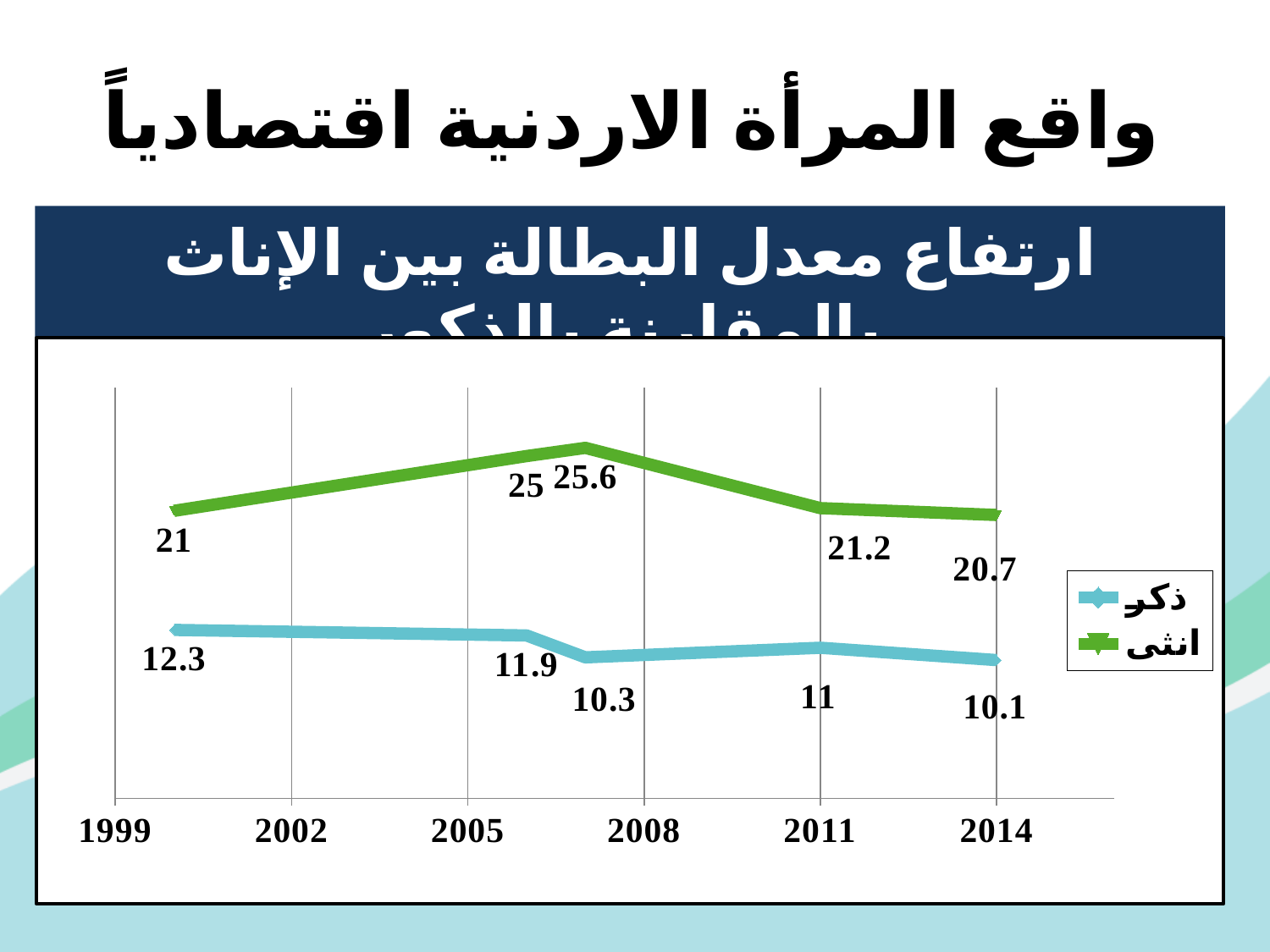
What is the value of the ذكر series at 2011? 11 How many labelled data points does each line have? 5 What is the difference between the انثى and ذكر values at 2014? 10.6 What is the highest value labelled on the انثى (green) line? 25.6 What is the value of the ذكر (blue) series at 2014? 10.1 What is the value of the انثى (green) series at 2014? 20.7 What is the value of the انثى series at 2011? 21.2 What is the lowest value labelled on the ذكر (blue) line? 10.1 What kind of chart is shown on the slide? line chart What are the two series named in the legend? ذكر and انثى Which series has higher values across the whole chart, ذكر or انثى? انثى How many series does the legend list? 2